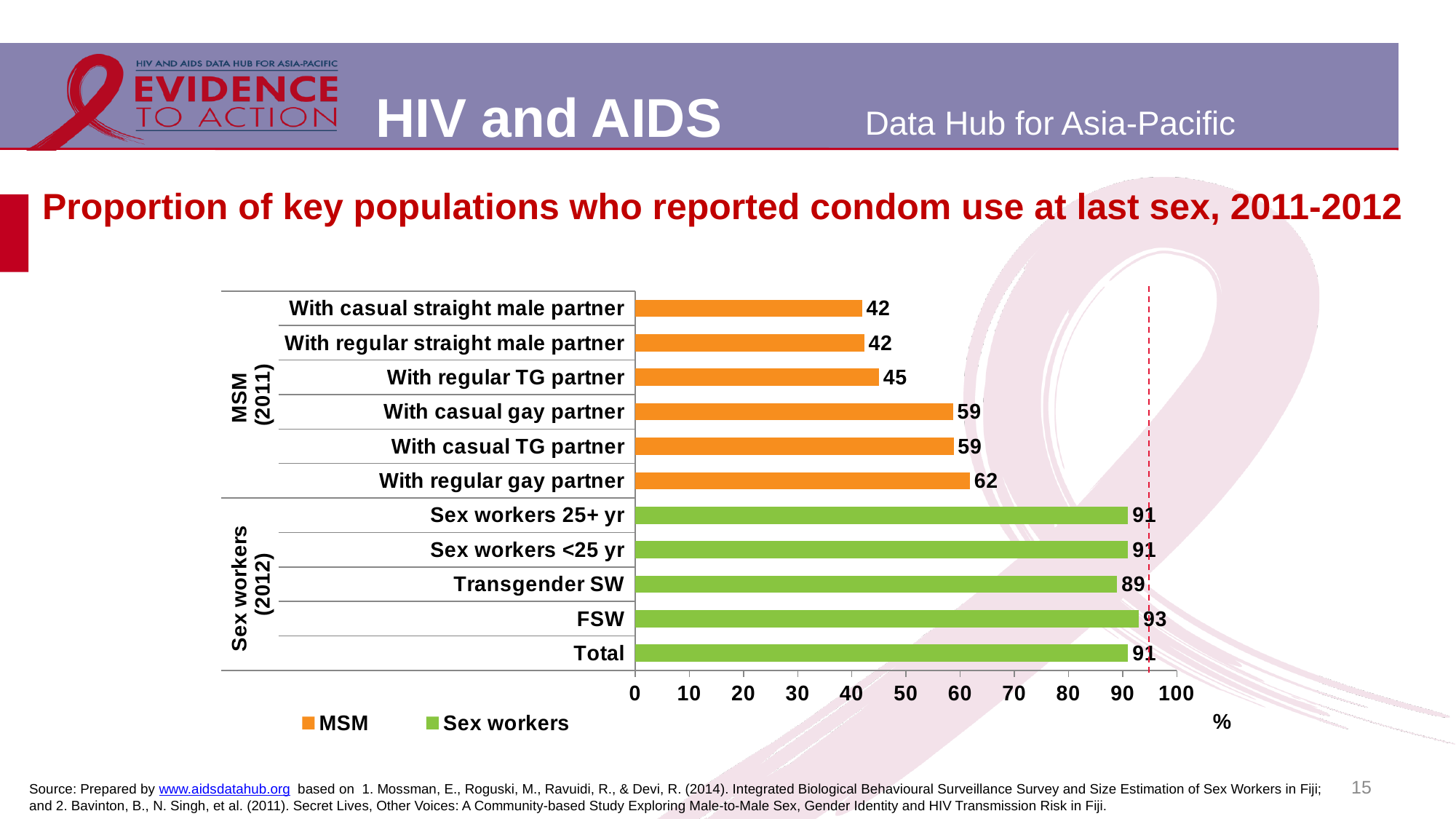
What value is shown for FSW? 93 What value is shown for 'With regular gay partner'? 62 Which is larger, the value for 'With regular TG partner' or the value for 'With casual gay partner'? With casual gay partner What is the difference between the values for 'With regular gay partner' and 'With casual straight male partner'? 20 Which colour represents the Sex workers series in the legend? Green Which category has the highest value on the chart? FSW How many categories are plotted on the chart? 11 What kind of chart is shown on the slide? Bar chart Which MSM category has the highest value? With regular gay partner How many series does the legend list? 2 What value is shown for Transgender SW? 89 What is the difference between the values for FSW and Transgender SW? 4